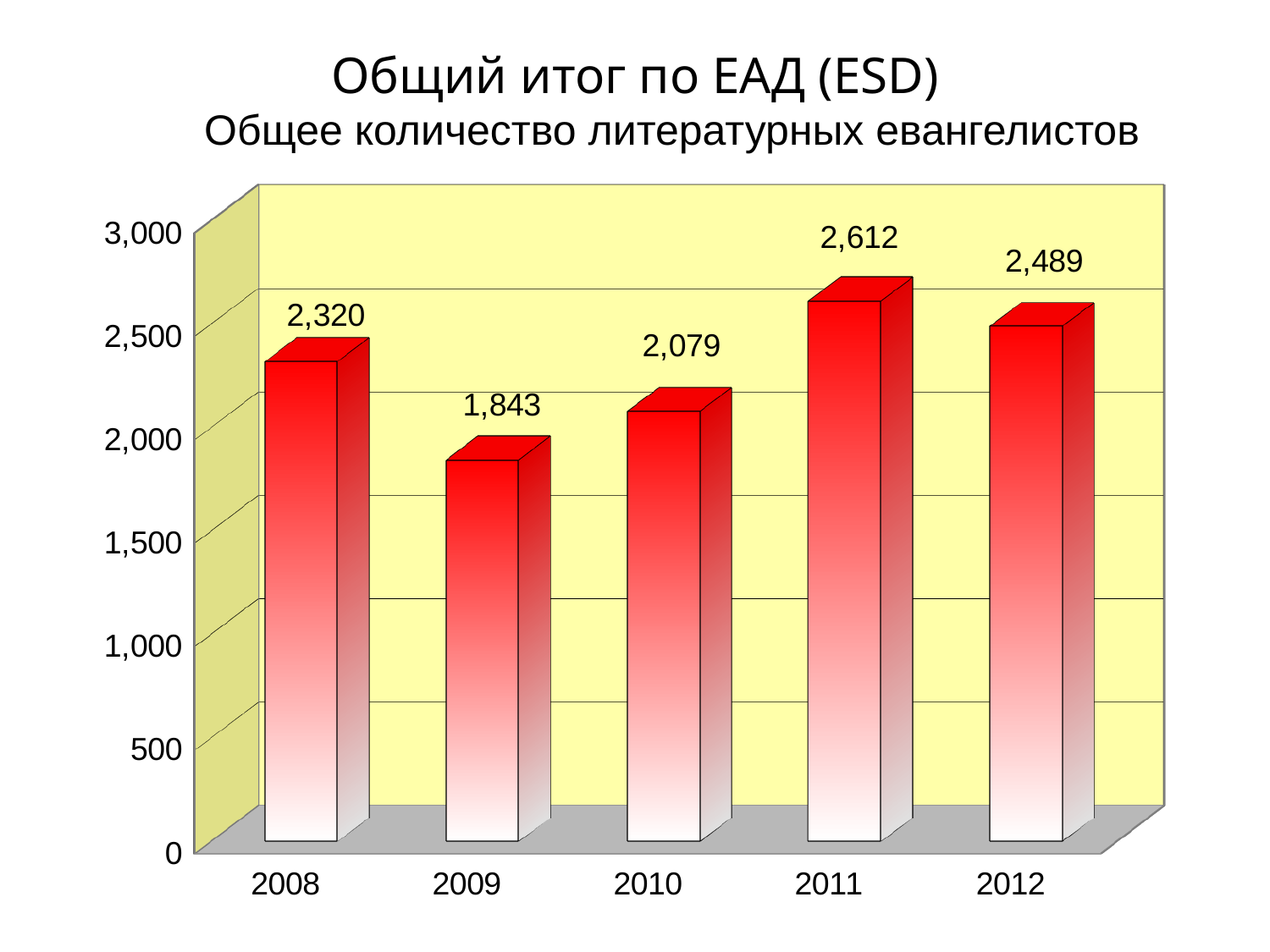
What is the difference between the values for 2011 and 2012? 123 What is the value for 2012? 2,489 Which year has the highest value? 2011 Which year has the lowest value? 2009 What is the value for 2009? 1,843 How many years are shown on the x axis? 5 What is the value for 2011? 2,612 What kind of chart is this? bar chart What is the difference between the values for 2010 and 2009? 236 What is the value for 2008? 2,320 Does the value rise or fall from 2009 to 2011? rise Which is larger, the value for 2008 or the value for 2010? 2008